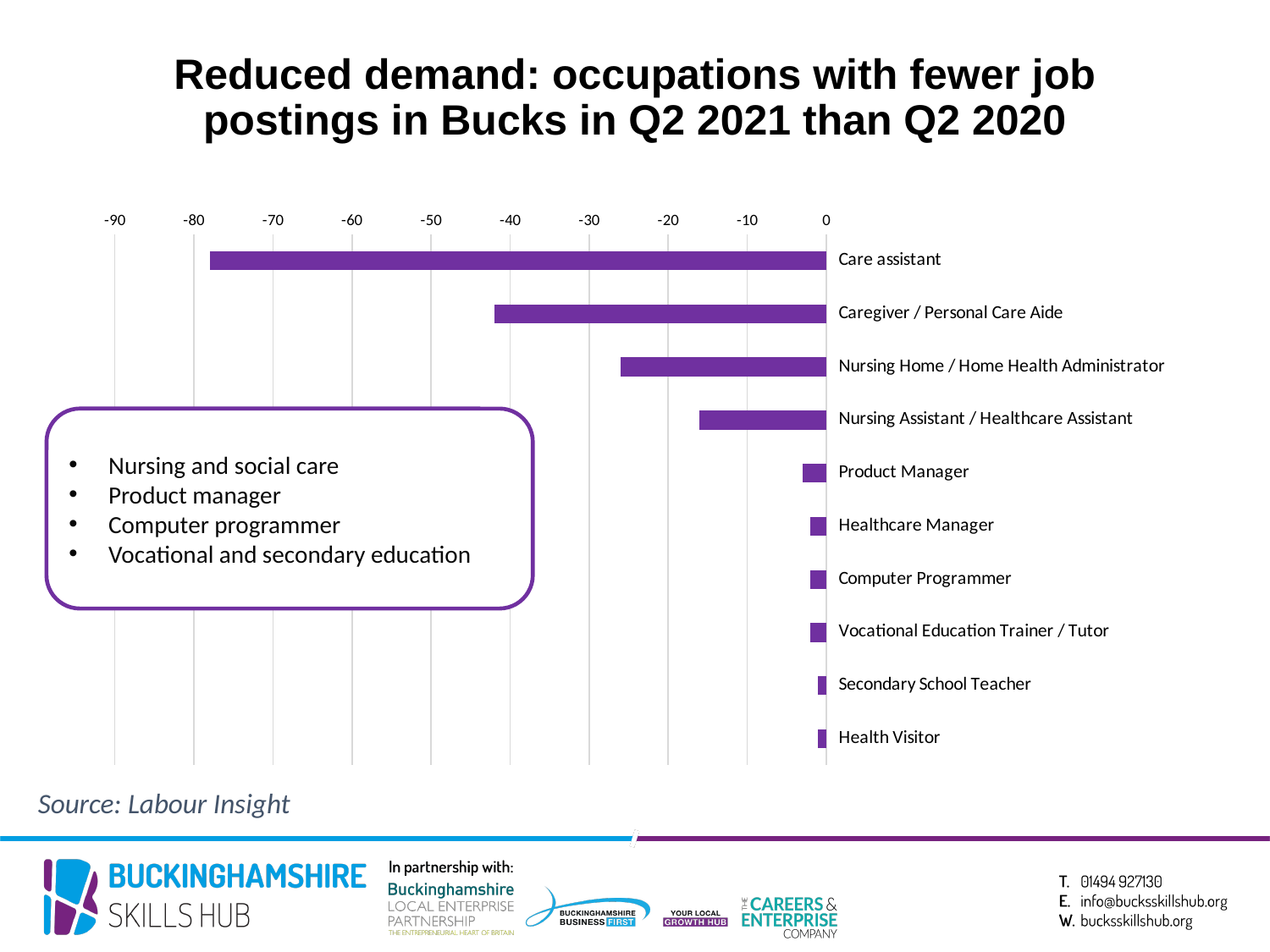
Is the value for Nursing Assistant / Healthcare Assistant greater or less than -20? greater Which occupation shows the largest reduction in job postings? Care assistant Which shows a larger decrease in job postings: Care assistant or Caregiver / Personal Care Aide? Care assistant Is the value for Product Manager greater or less than -10? greater Which shows a larger decrease in job postings: Nursing Home / Home Health Administrator or Nursing Assistant / Healthcare Assistant? Nursing Home / Home Health Administrator Is the value for Caregiver / Personal Care Aide greater or less than -30? less What kind of chart is shown on the slide? Bar chart What is the lowest value shown on the chart's horizontal axis? -90 How many occupations are plotted in the chart? 10 What is the source cited for the chart data? Labour Insight